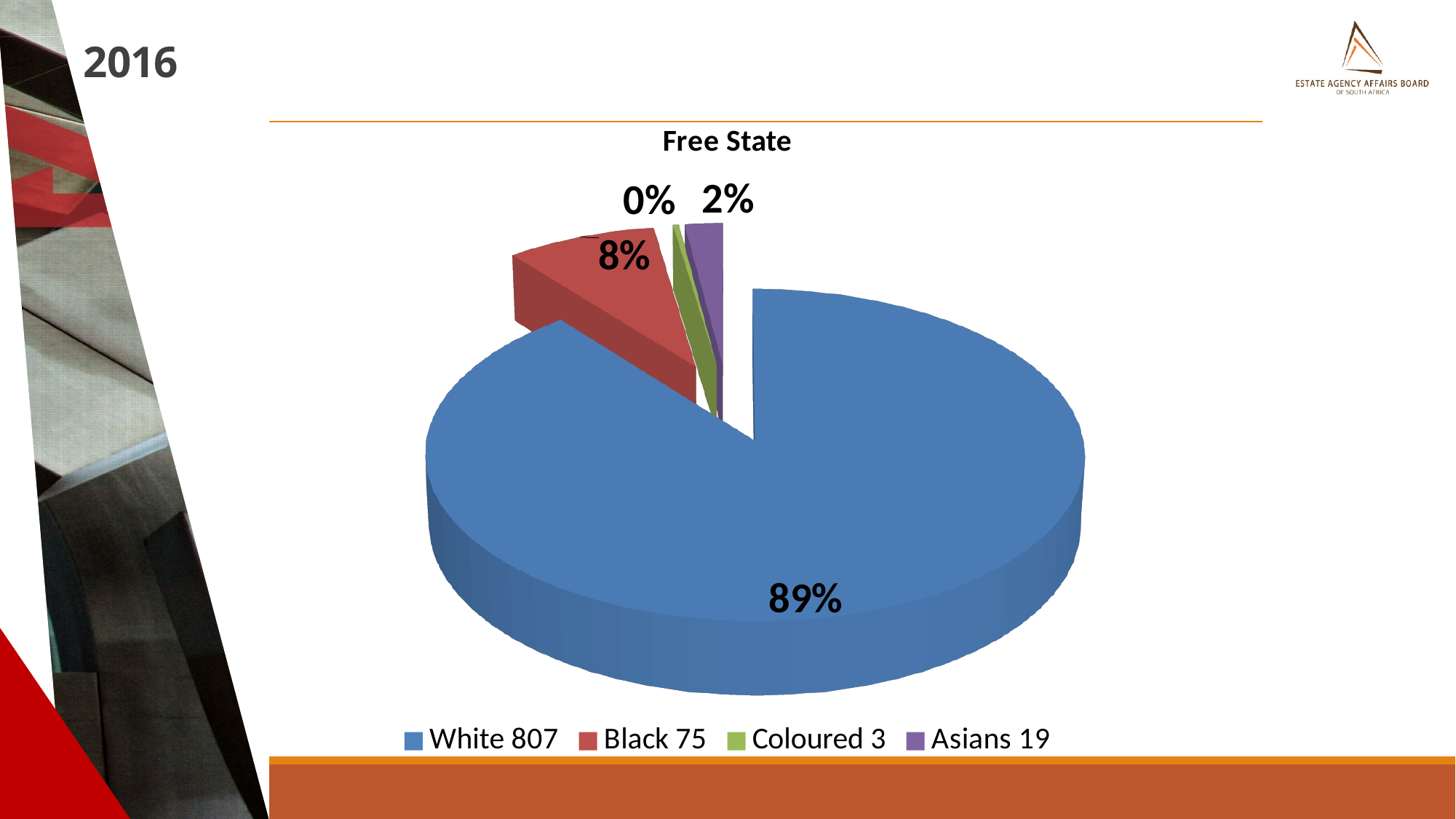
Which category has the smallest slice? Coloured What is the difference between the values for Black and Asians? 56 What is the title of the chart? Free State Which category has the largest slice? White What value is shown for Coloured in the legend? 3 What percentage share does the Coloured slice have? 0% What percentage share does the Black slice have? 8% What type of chart is shown on the slide? pie chart What percentage share does the White slice have? 89% What value is shown for White in the legend? 807 How many slices does the pie chart have? 4